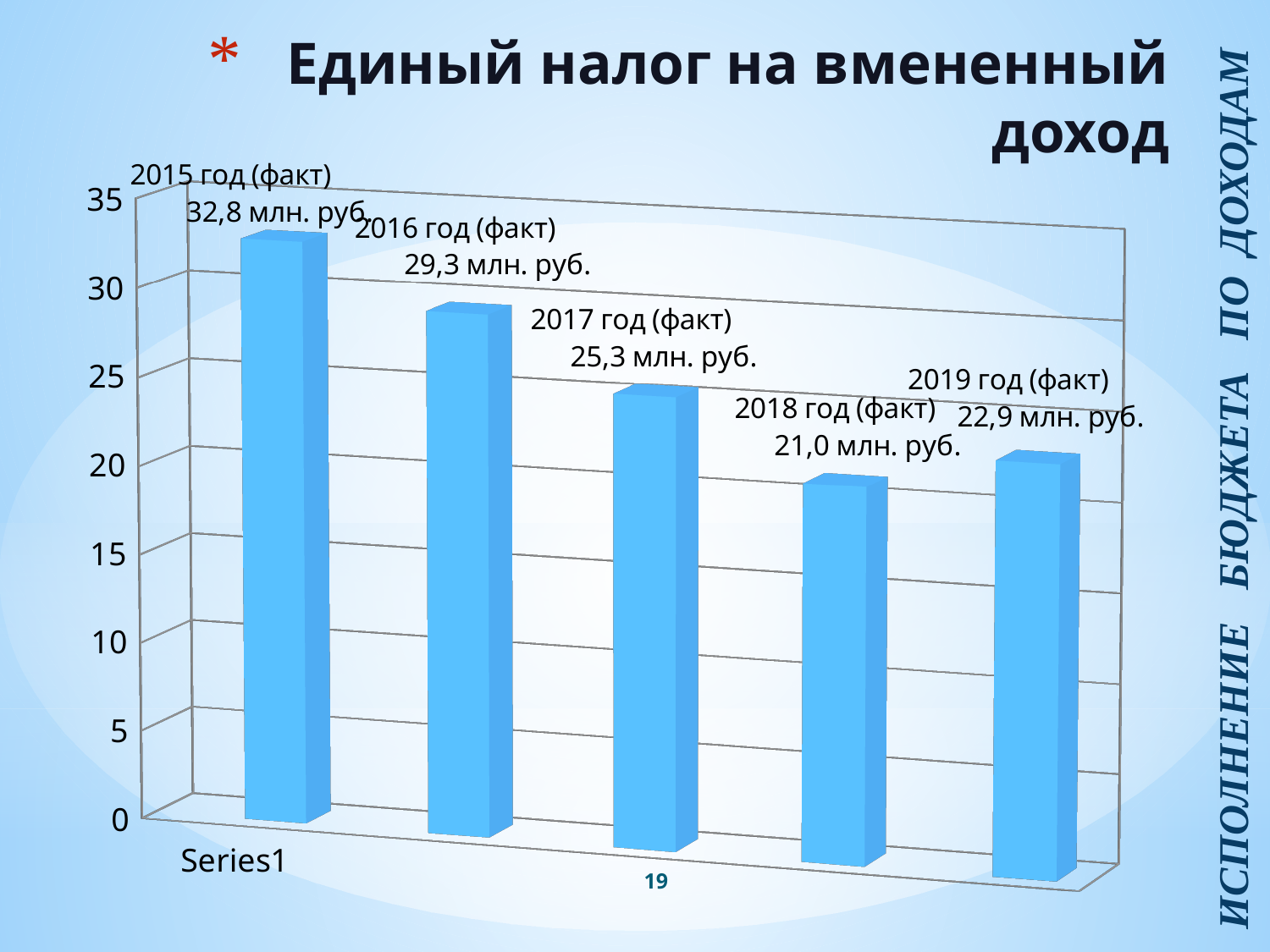
How many bars are shown in the chart? 5 What is the difference between the values for 2019 год (факт) and 2018 год (факт)? 1,9 млн. руб. What is the value for 2017 год (факт)? 25,3 млн. руб. Which is larger, the value for 2016 год (факт) or 2017 год (факт)? 2016 год (факт) What is the title of the chart on the slide? Единый налог на вмененный доход Which year has the lowest value? 2018 год (факт) What is the value for 2019 год (факт)? 22,9 млн. руб. What is the difference between the values for 2015 год (факт) and 2016 год (факт)? 3,5 млн. руб. What kind of chart is shown on the slide? bar chart What is the value for 2015 год (факт)? 32,8 млн. руб. Which year has the highest value? 2015 год (факт) Is the value for 2018 год (факт) greater or less than 25? less